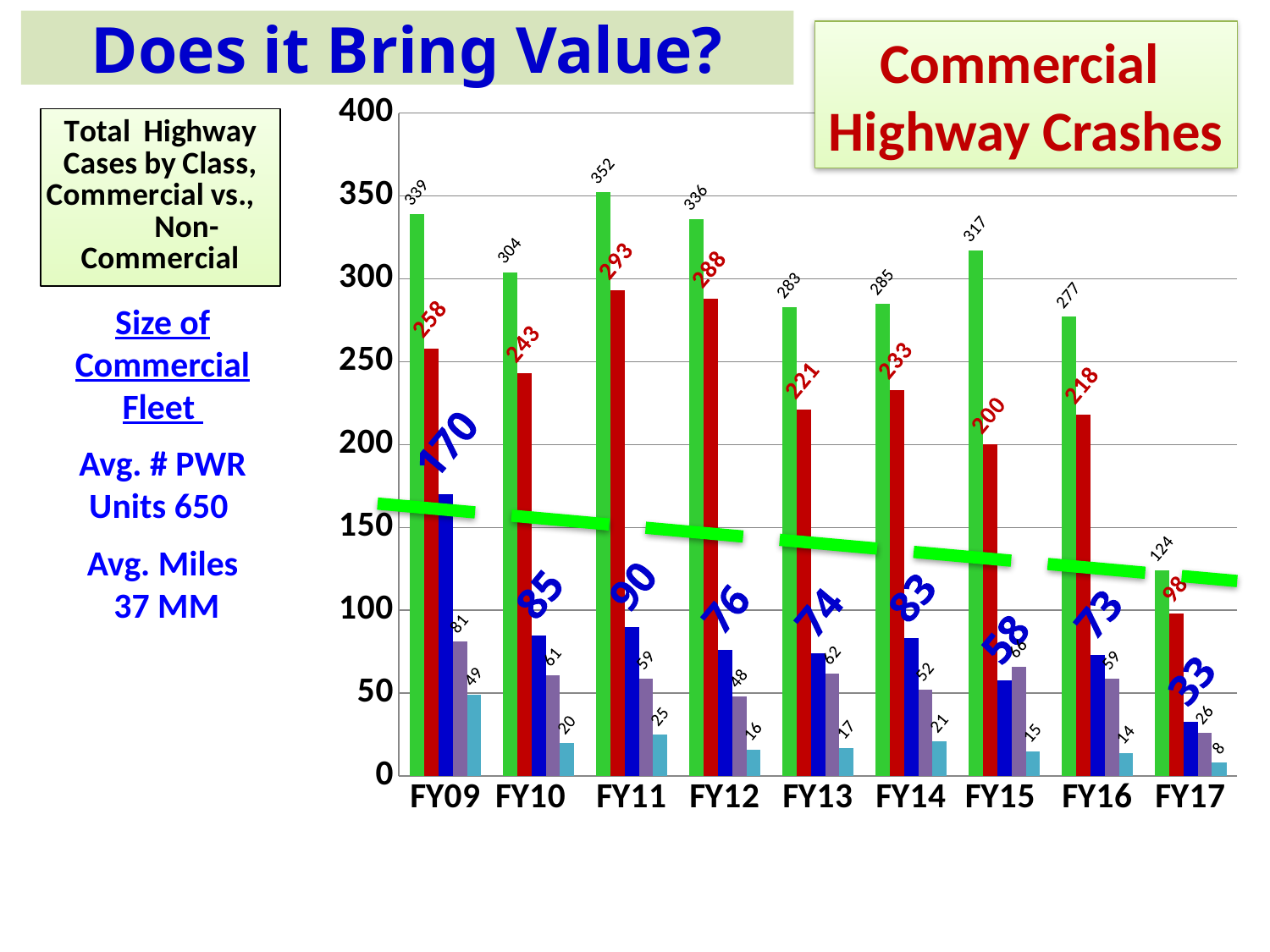
What kind of chart is shown on the slide? Bar chart In which fiscal year is the blue bar (Commercial Highway Crashes) lowest? FY17 Do the blue bar (Commercial Highway Crashes) values generally rise or fall from FY09 to FY17? Fall What is the value of the red bar for FY13? 221 How many fiscal years are shown on the x axis? 9 What is the value of the light blue bar for FY17? 8 Which is larger, the red bar for FY11 or the red bar for FY12? FY11 Is the green bar for FY15 greater or less than 300? greater What is the value of the tallest (green) bar for FY11? 352 In which fiscal year is the green bar highest? FY11 What is the value of the large blue-labelled bar (Commercial Highway Crashes) for FY09? 170 What is the difference between the green bar values for FY09 and FY17? 215